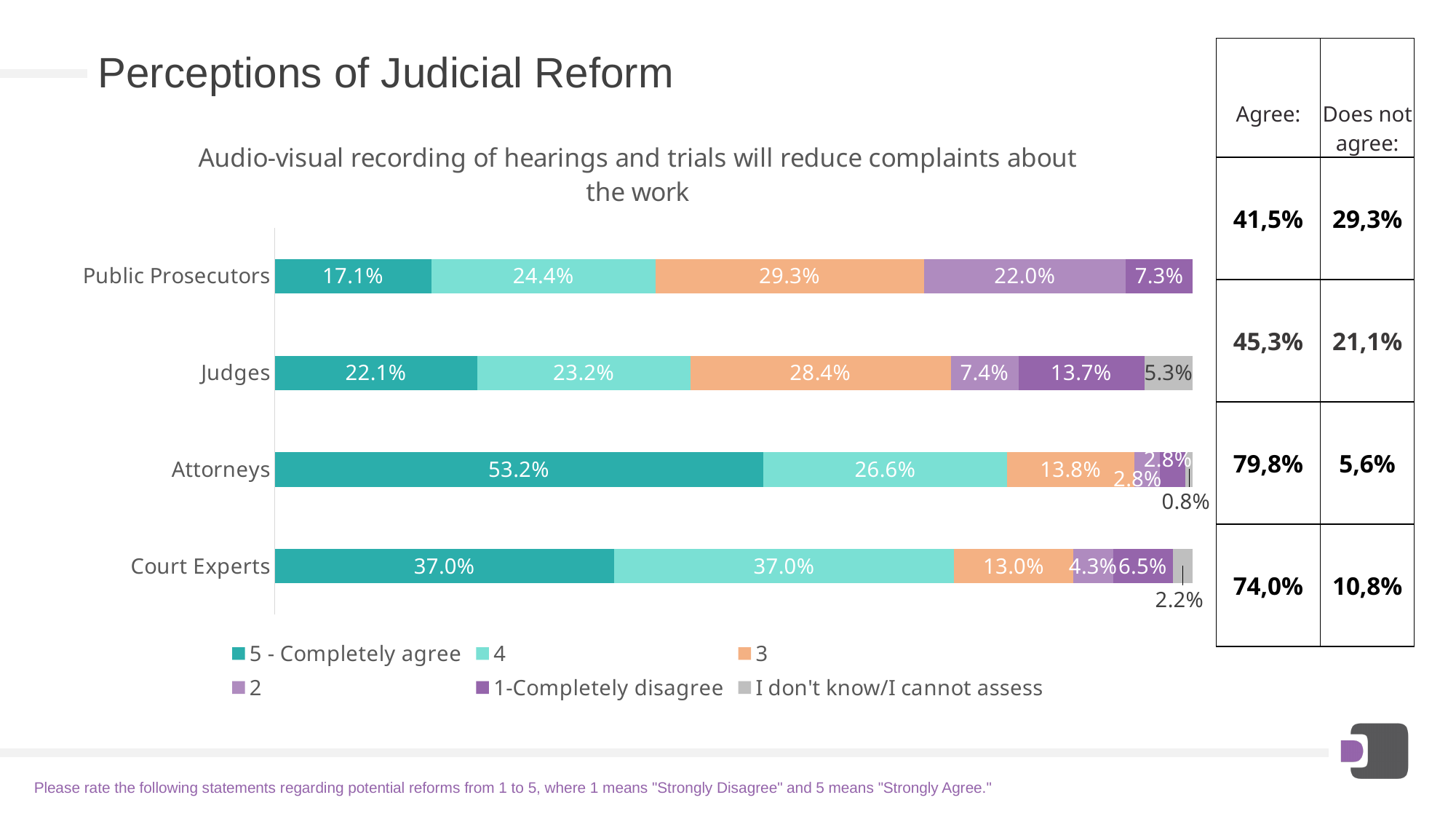
What percentage of Court Experts answered "I don't know/I cannot assess"? 2.2% How many respondent groups are shown on the chart? 4 What is the title of the chart? Audio-visual recording of hearings and trials will reduce complaints about the work What percentage of Public Prosecutors gave a rating of 3? 29.3% What percentage of Judges answered "1-Completely disagree"? 13.7% Which is larger: the rating-3 share for Judges or for Court Experts? Judges What type of chart is shown on the slide? Stacked bar chart What is the difference between the "5 - Completely agree" shares of Attorneys and Judges? 31.1% Which group has the lowest share of "5 - Completely agree" responses? Public Prosecutors How many series does the legend list? 6 Which group has the highest share of "5 - Completely agree" responses? Attorneys What percentage of Attorneys answered "5 - Completely agree"? 53.2%